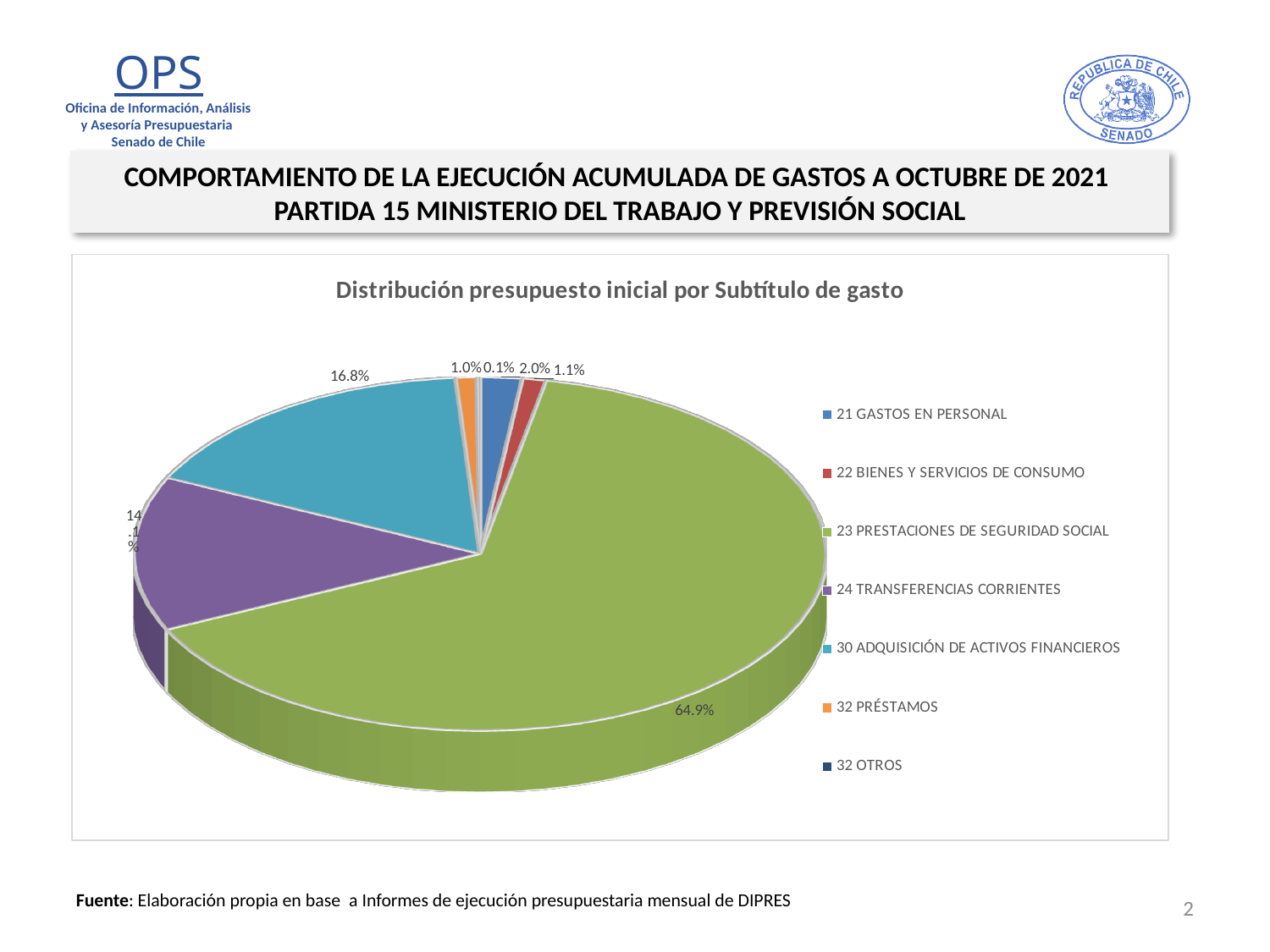
Which category has the smallest share of the pie? 32 OTROS What is the difference in percentage points between the share for 30 ADQUISICIÓN DE ACTIVOS FINANCIEROS and the share for 24 TRANSFERENCIAS CORRIENTES? 2.7 Which is larger: the share for 30 ADQUISICIÓN DE ACTIVOS FINANCIEROS or the share for 24 TRANSFERENCIAS CORRIENTES? 30 ADQUISICIÓN DE ACTIVOS FINANCIEROS What share of the pie does 23 PRESTACIONES DE SEGURIDAD SOCIAL represent? 64.9% What share of the pie does 30 ADQUISICIÓN DE ACTIVOS FINANCIEROS represent? 16.8% How many entries does the chart legend list? 7 What share of the pie does 21 GASTOS EN PERSONAL represent? 2.0% What colour is the slice for 23 PRESTACIONES DE SEGURIDAD SOCIAL? Green What is the title of the chart? Distribución presupuesto inicial por Subtítulo de gasto Which category has the largest share of the pie? 23 PRESTACIONES DE SEGURIDAD SOCIAL What kind of chart is shown on the slide? Pie chart What share of the pie does 24 TRANSFERENCIAS CORRIENTES represent? 14.1%